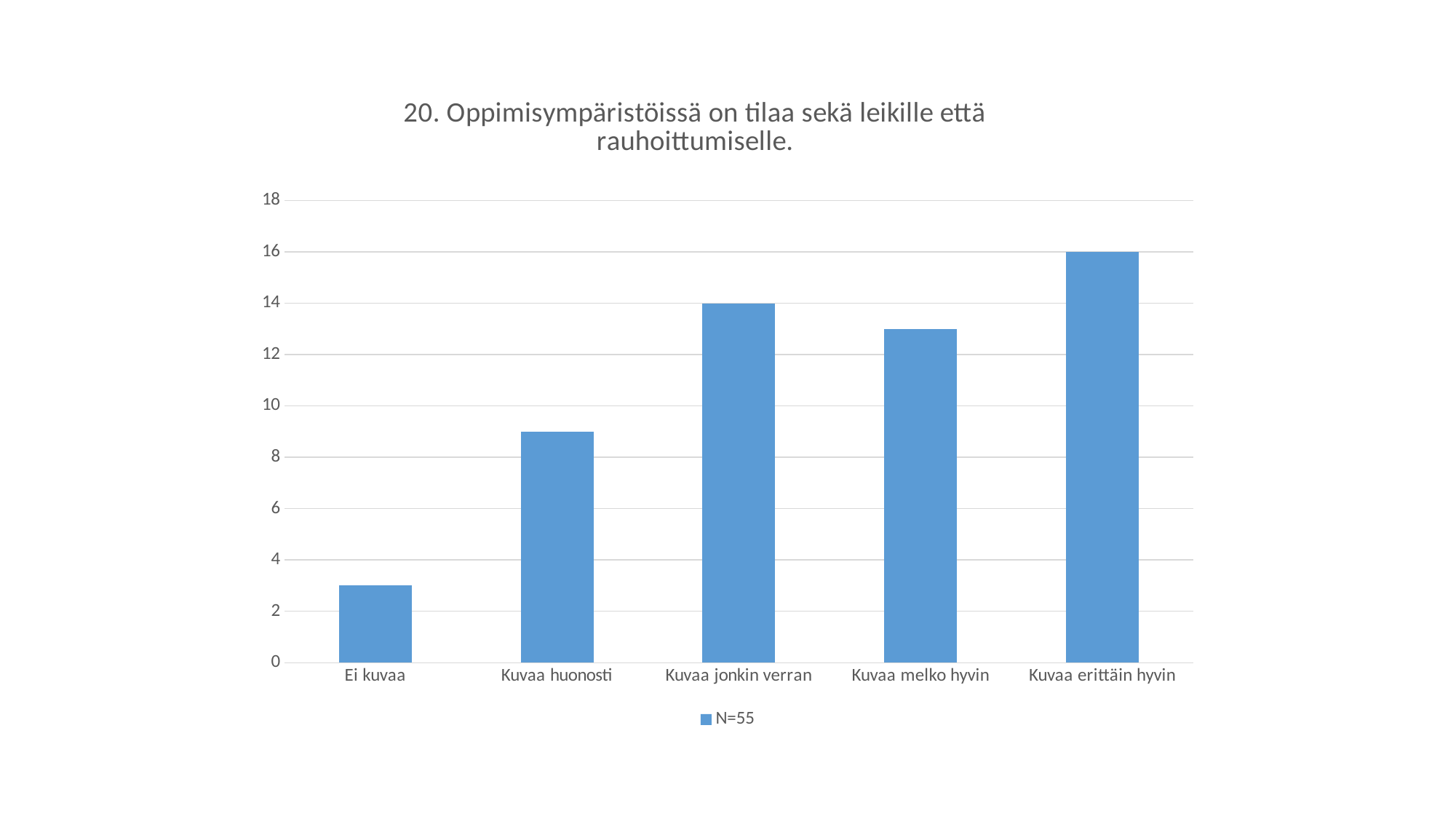
Which category has the highest value? Kuvaa erittäin hyvin Which is larger, the value for "Kuvaa huonosti" or the value for "Kuvaa melko hyvin"? Kuvaa melko hyvin How many categories are shown on the x axis of the chart? 5 What is the legend entry shown below the chart? N=55 Is the value for "Kuvaa huonosti" greater or less than 8? greater What is the value for "Kuvaa erittäin hyvin"? 16 What is the value for "Kuvaa jonkin verran"? 14 Which category has the lowest value? Ei kuvaa What is the difference between the values for "Kuvaa erittäin hyvin" and "Kuvaa jonkin verran"? 2 How many series does the legend list? 1 Is the value for "Ei kuvaa" greater or less than 4? less What type of chart is shown on the slide? bar chart